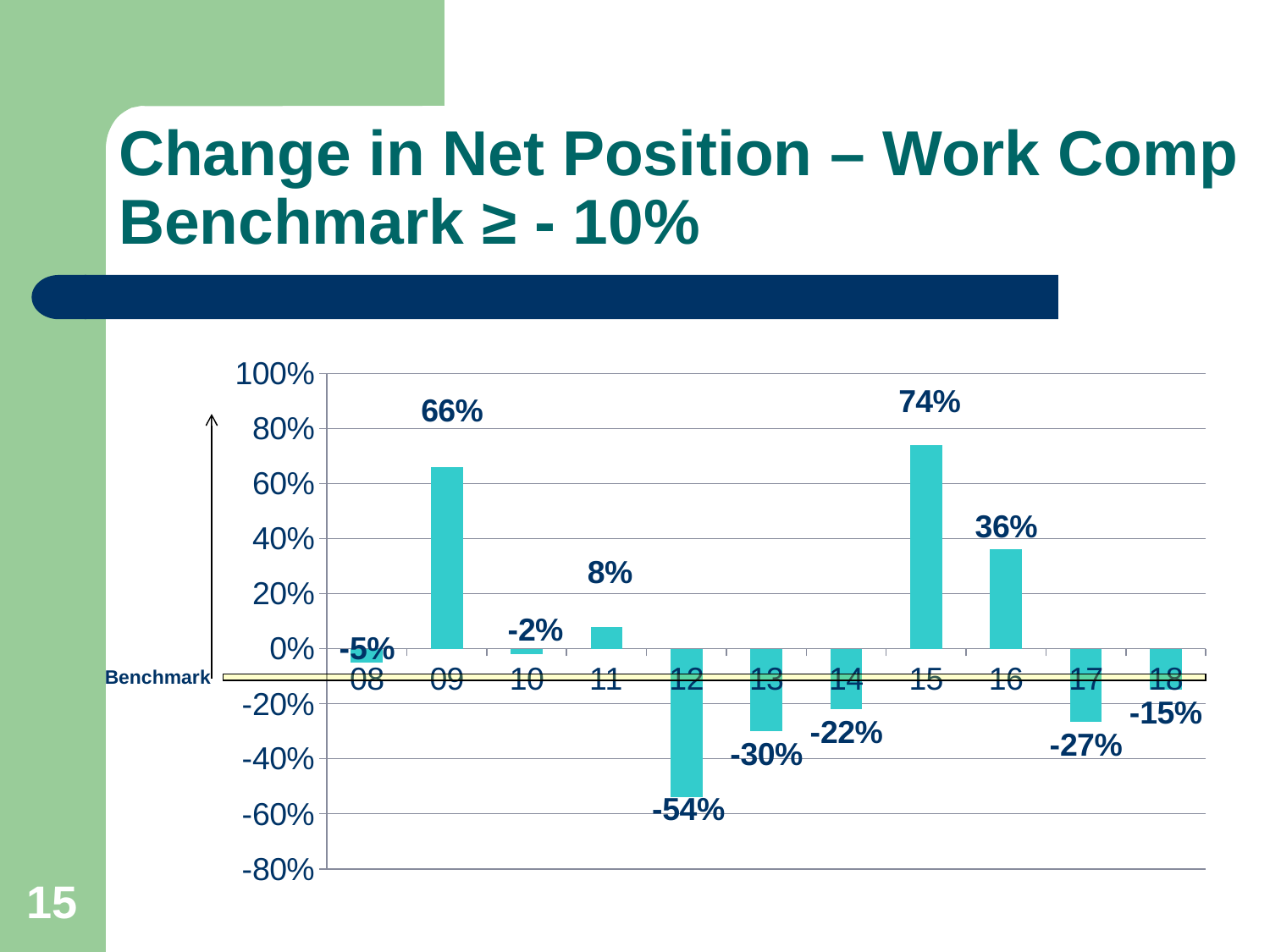
What is the difference between the values for 17 and 18? 12% What is the benchmark value stated in the slide title? ≥ -10% What is the change in net position for 09? 66% Which is larger, the value for 13 or the value for 14? 14 How many years are shown on the x axis? 11 What kind of chart is shown on the slide? bar chart Which year has the lowest change in net position? 12 What is the difference between the values for 15 and 09? 8% Which year has the highest change in net position? 15 What is the change in net position for 16? 36% What is the change in net position for 18? -15% What is the change in net position for 12? -54%